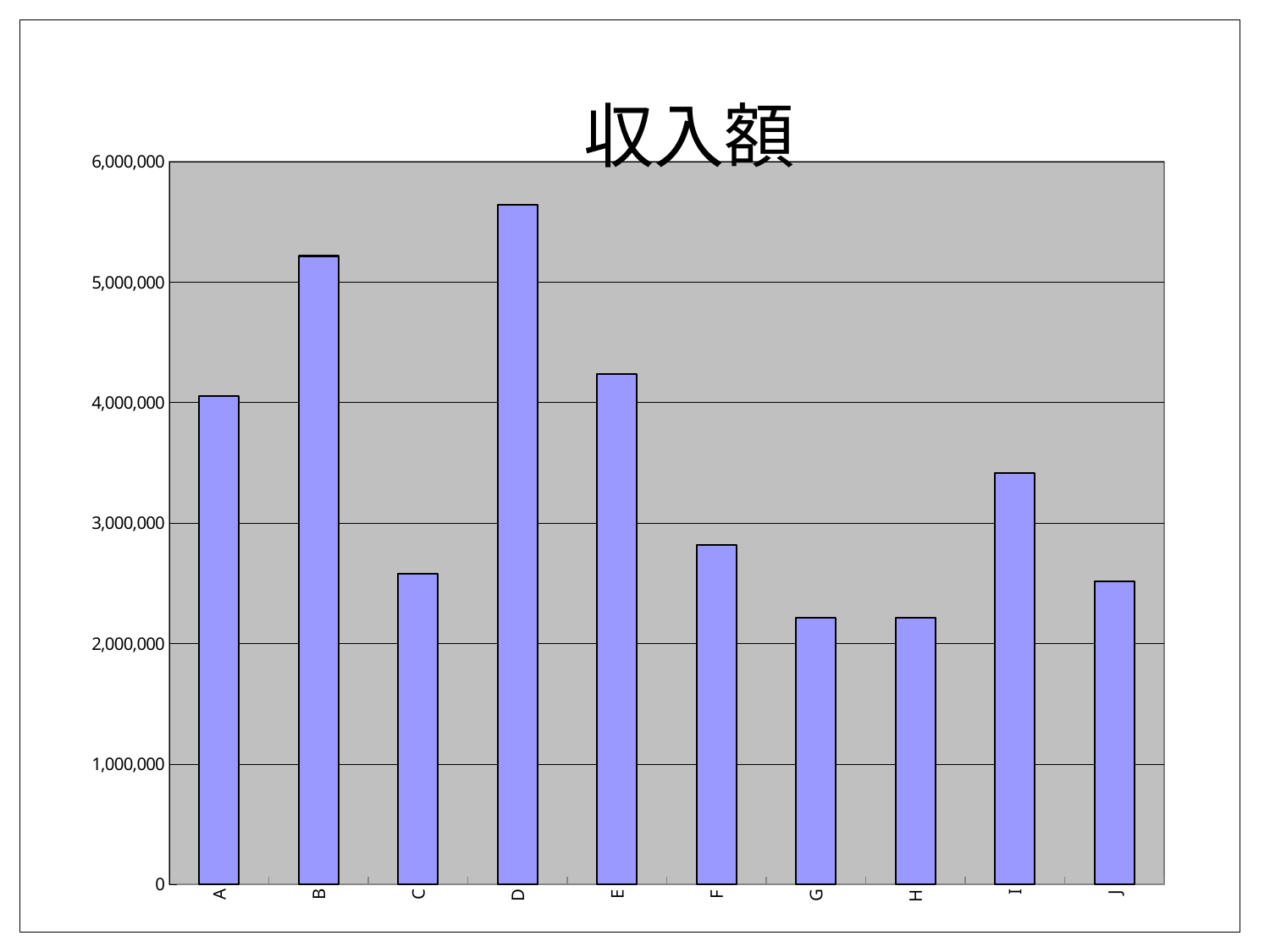
Which is larger, the value for B or the value for E? B Which is larger, the value for I or the value for F? I Is the value for B greater or less than 5,000,000? greater How many categories are plotted on the x axis? 10 What is the title of the chart? 収入額 Is the value for J greater or less than 3,000,000? less Is the value for I greater or less than 3,000,000? greater Which category has the highest value? D What kind of chart is shown on the slide? bar chart